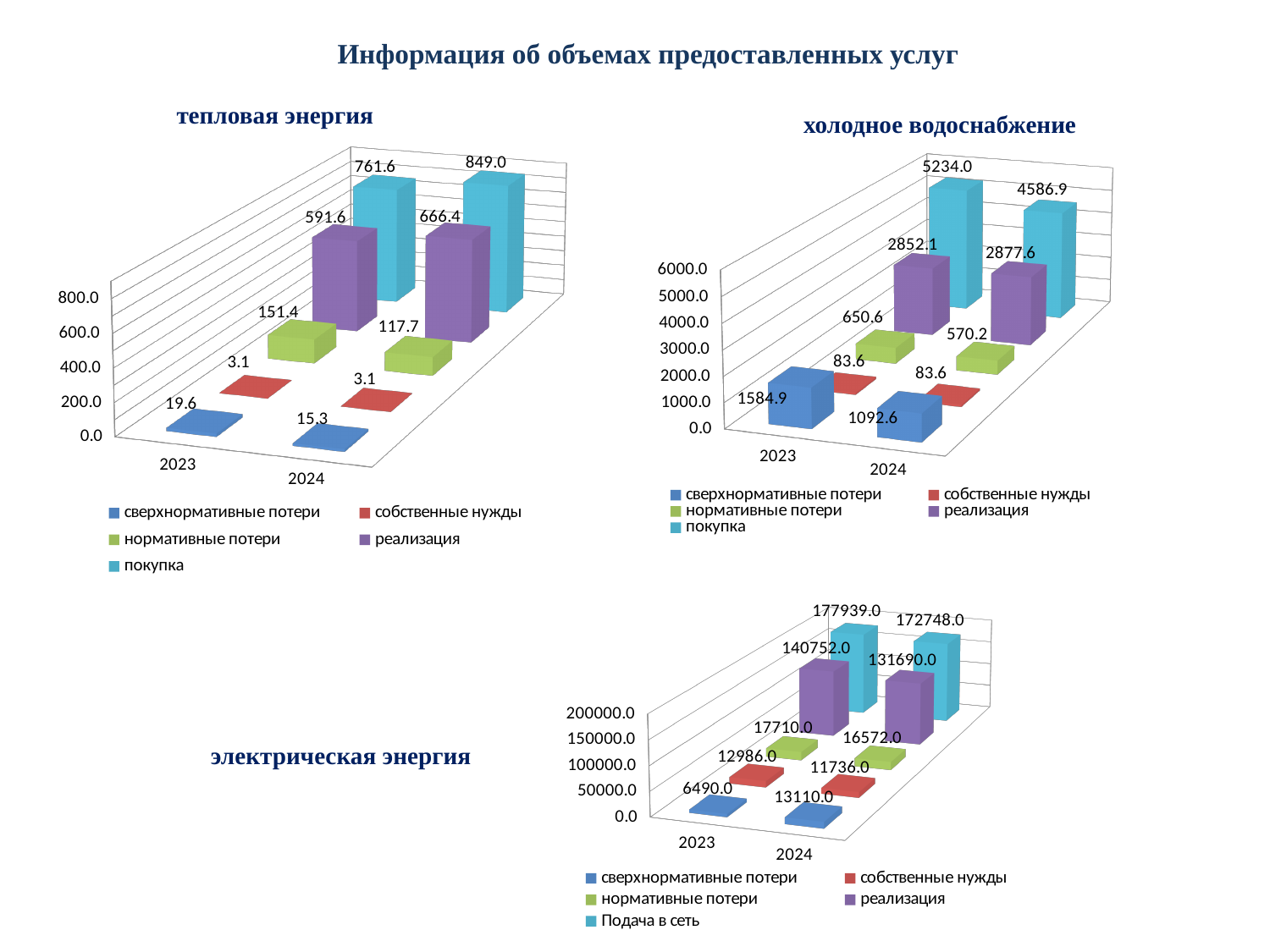
In the 'тепловая энергия' chart, what is the value of 'покупка' for 2024? 849.0 What type of chart is the 'тепловая энергия' chart? bar chart In the 'холодное водоснабжение' chart, what is the value of 'сверхнормативные потери' for 2023? 1584.9 In the 'холодное водоснабжение' chart, is 'покупка' larger in 2023 or in 2024? 2023 In the 'электрическая энергия' chart, what is the difference between 'реализация' in 2023 and in 2024? 9062.0 In the 'тепловая энергия' chart, what is the value of 'нормативные потери' for 2023? 151.4 In the 'холодное водоснабжение' chart, which series has the highest value in 2023? покупка In the 'холодное водоснабжение' chart, what is the value of 'собственные нужды' for 2024? 83.6 In the 'тепловая энергия' chart, what is the difference between 'реализация' in 2024 and in 2023? 74.8 In the 'электрическая энергия' chart, what is the value of 'Подача в сеть' for 2023? 177939.0 In the 'электрическая энергия' chart, which series has the lowest value in 2023? сверхнормативные потери How many series does the legend of the 'электрическая энергия' chart list? 5